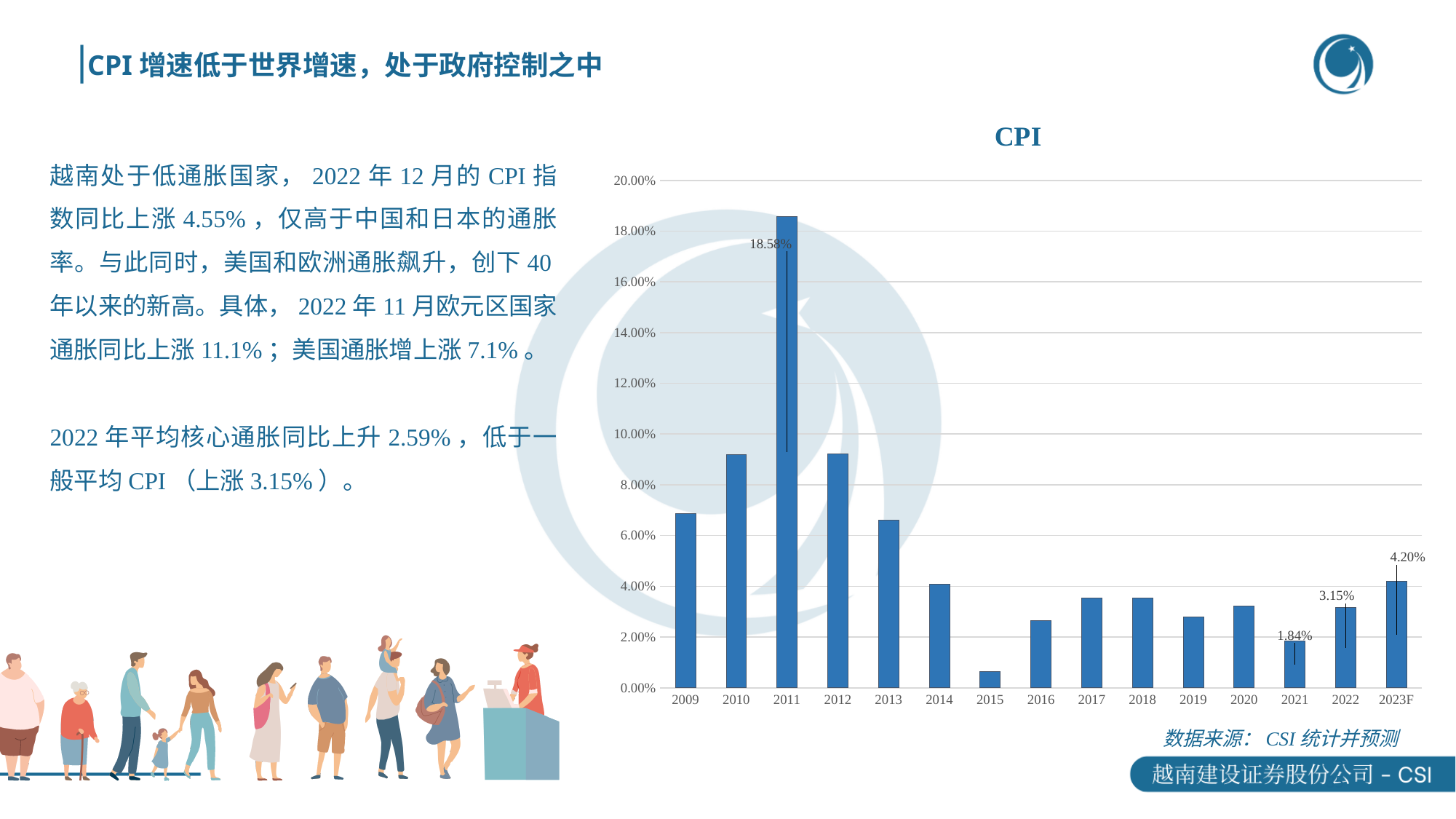
What kind of chart is used to show the CPI data? bar chart What is the CPI value shown for 2023F? 4.20% What is the CPI value shown for 2021? 1.84% Is the CPI value for 2009 greater or less than 6.00%? greater What is the difference between the CPI values for 2022 and 2021? 1.31% What is the CPI value shown for 2011? 18.58% Do the CPI values rise or fall from 2011 to 2015? fall How many years are shown on the x axis of the CPI chart? 15 Which year has a larger CPI value, 2010 or 2013? 2010 What is the CPI value shown for 2022? 3.15% Which year has the lowest CPI value in the chart? 2015 Which year has the highest CPI value in the chart? 2011